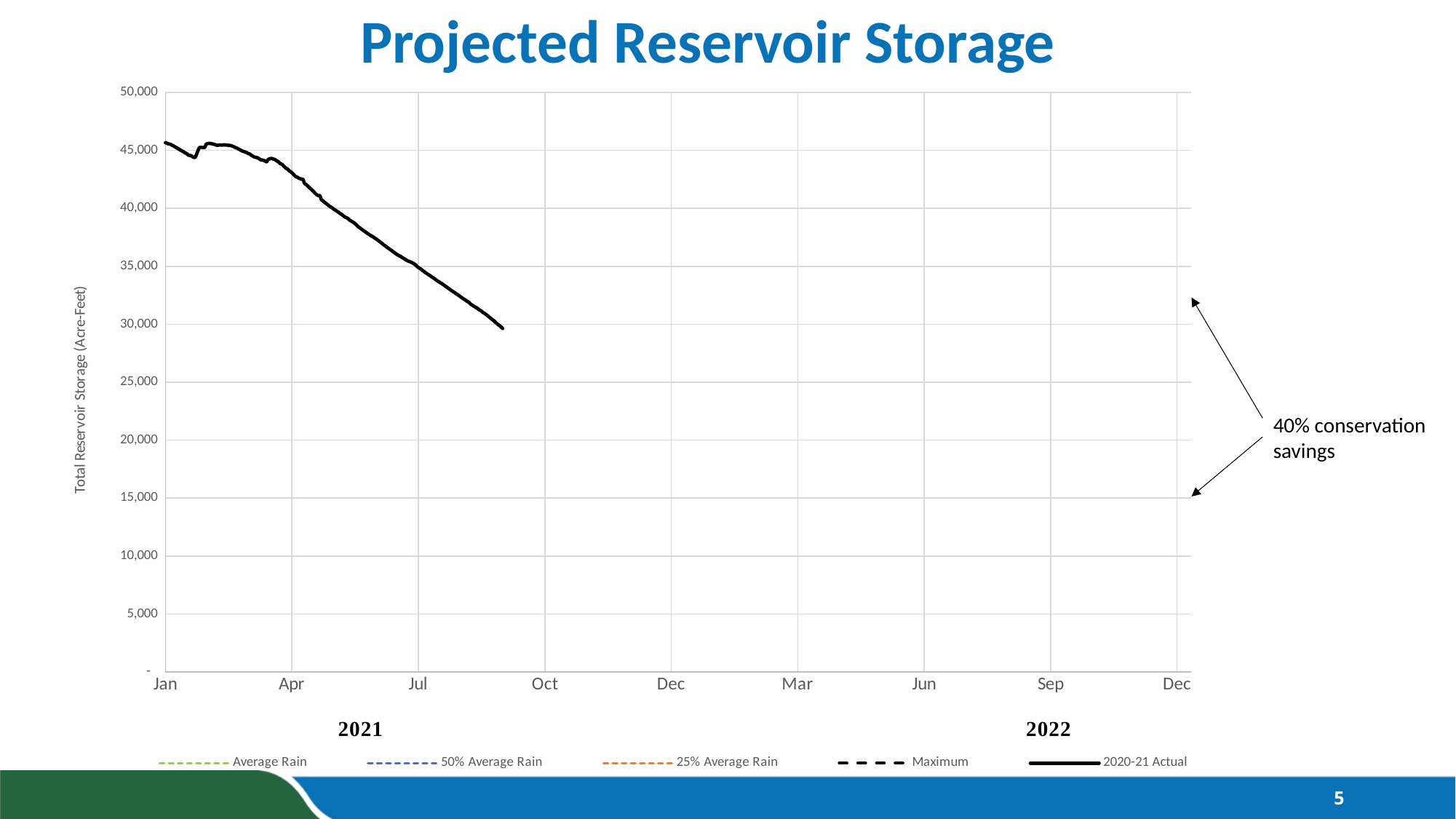
Is the 2020-21 Actual value in Jul 2021 greater or less than 40,000? less What is the highest value shown on the vertical axis? 50,000 Which is larger for the 2020-21 Actual series: the value in Jan 2021 or the value in Jul 2021? Jan 2021 Is the 2020-21 Actual value in Apr 2021 greater or less than 40,000? greater Which series is plotted as a solid black line according to the legend? 2020-21 Actual Is the last plotted 2020-21 Actual value greater or less than 35,000? less What is the label on the vertical axis? Total Reservoir Storage (Acre-Feet) How many series does the legend list? 5 Does the 2020-21 Actual line rise or fall from Jan 2021 toward Sep 2021? Fall What kind of chart is shown on the slide? Line chart